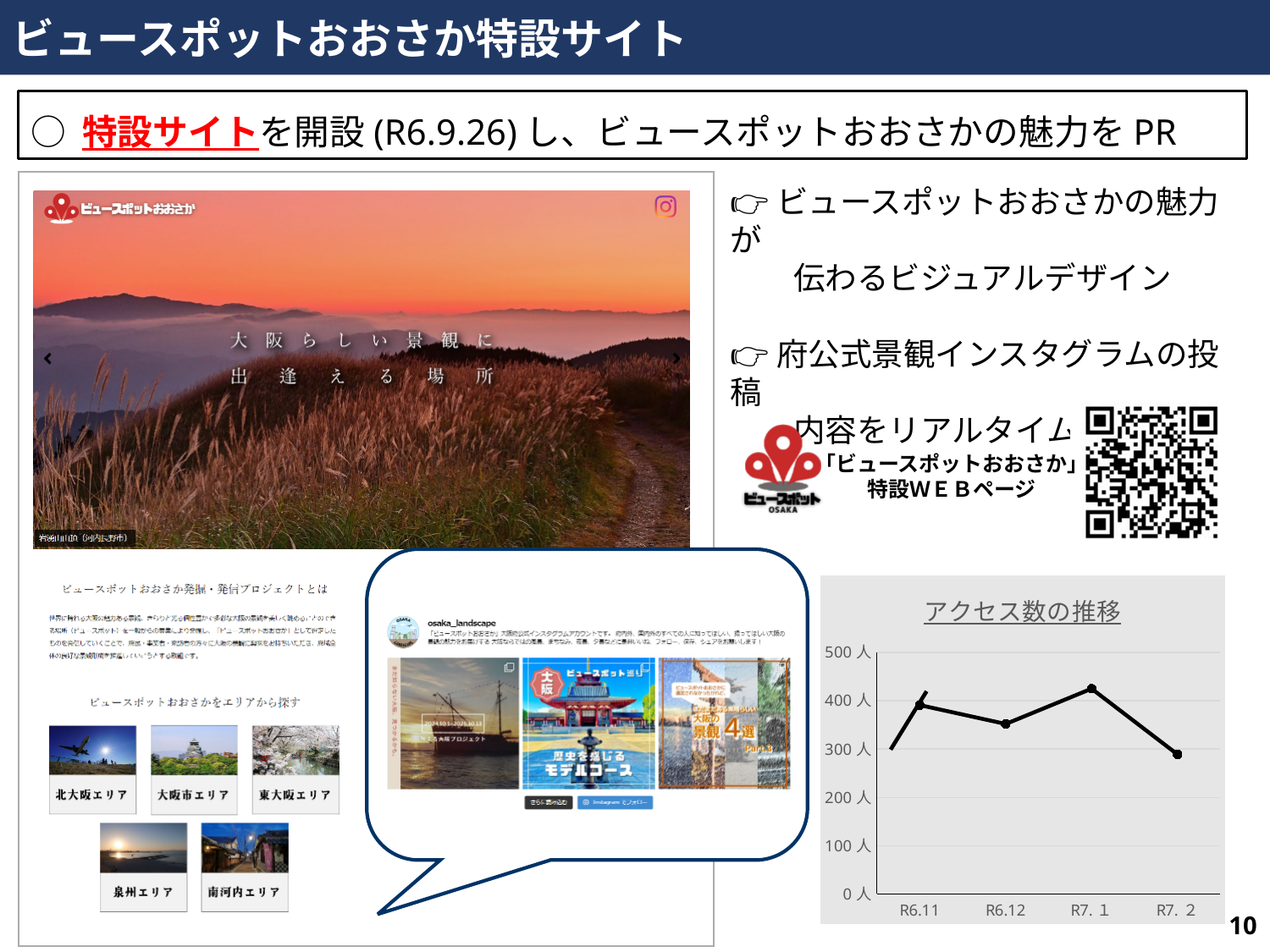
In the アクセス数の推移 chart, which is larger, the value for R6.11 or the value for R6.12? R6.11 In the アクセス数の推移 chart, does the value rise or fall from R7. 1 to R7. 2? fall In the アクセス数の推移 chart, is the value for R7. 1 greater or less than 400人? greater In the アクセス数の推移 chart, is the value for R6.12 greater or less than 300人? greater What is the title of the chart on the slide? アクセス数の推移 In the アクセス数の推移 chart, which period has the lowest access count? R7. 2 In the アクセス数の推移 chart, does the value rise or fall from R6.12 to R7. 1? rise How many time points are plotted on the x axis of the アクセス数の推移 chart? 4 In the アクセス数の推移 chart, which period has the highest access count? R7. 1 What kind of chart is the アクセス数の推移 chart? line chart In the アクセス数の推移 chart, is the value for R6.12 greater or less than 400人? less